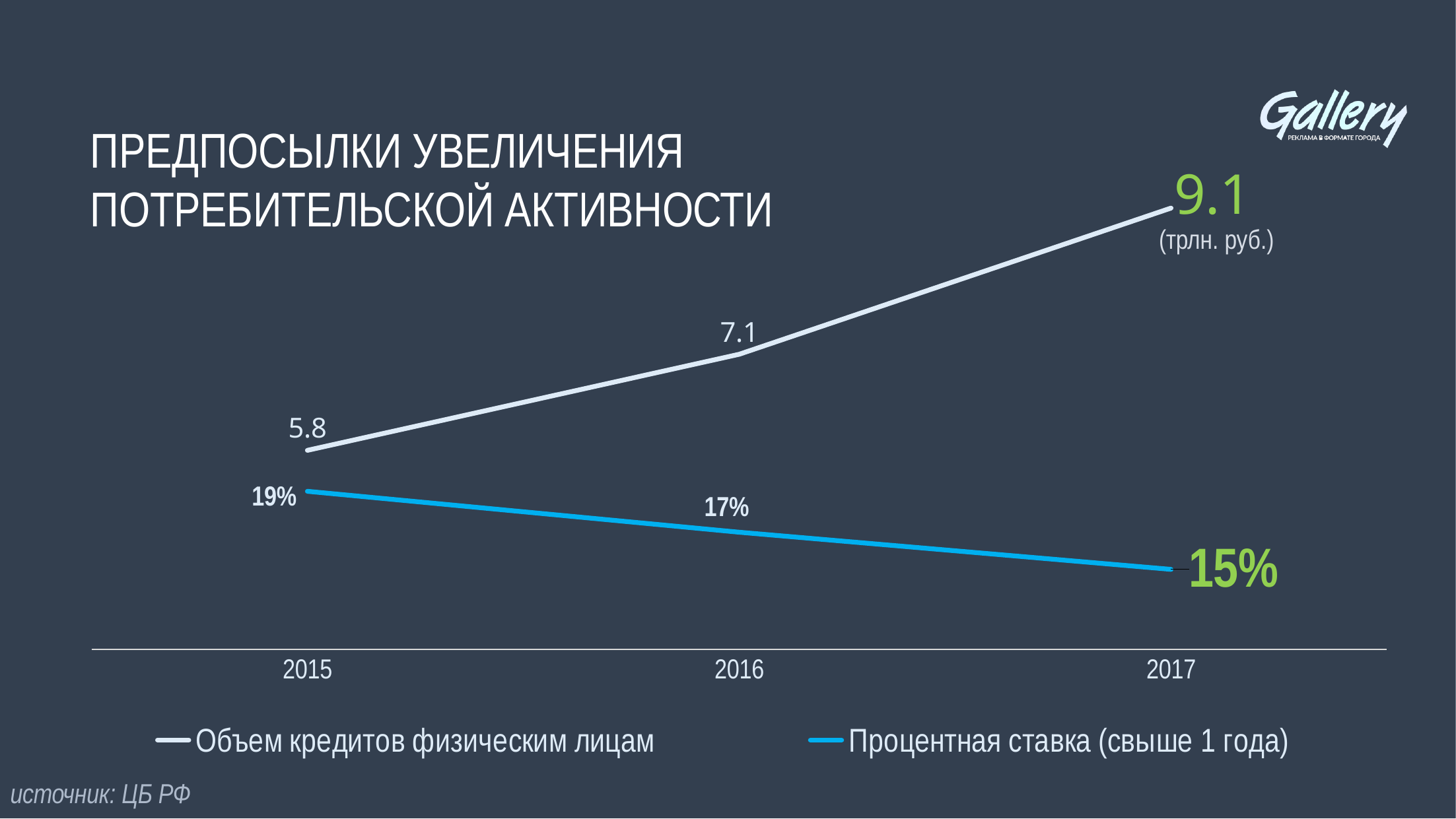
What is the difference between Объем кредитов физическим лицам in 2017 and in 2015? 3.3 In which year is Объем кредитов физическим лицам highest? 2017 What is the value of Объем кредитов физическим лицам in 2015? 5.8 What is the value of Объем кредитов физическим лицам in 2017? 9.1 Does Процентная ставка (свыше 1 года) rise or fall from 2015 to 2017? fall Does Объем кредитов физическим лицам rise or fall from 2015 to 2017? rise What kind of chart is shown on the slide? line chart What is the value of Процентная ставка (свыше 1 года) in 2016? 17% What is the value of Процентная ставка (свыше 1 года) in 2017? 15% In which year is Процентная ставка (свыше 1 года) lowest? 2017 How many series does the legend list? 2 By how many percentage points did Процентная ставка (свыше 1 года) fall from 2015 to 2017? 4 percentage points